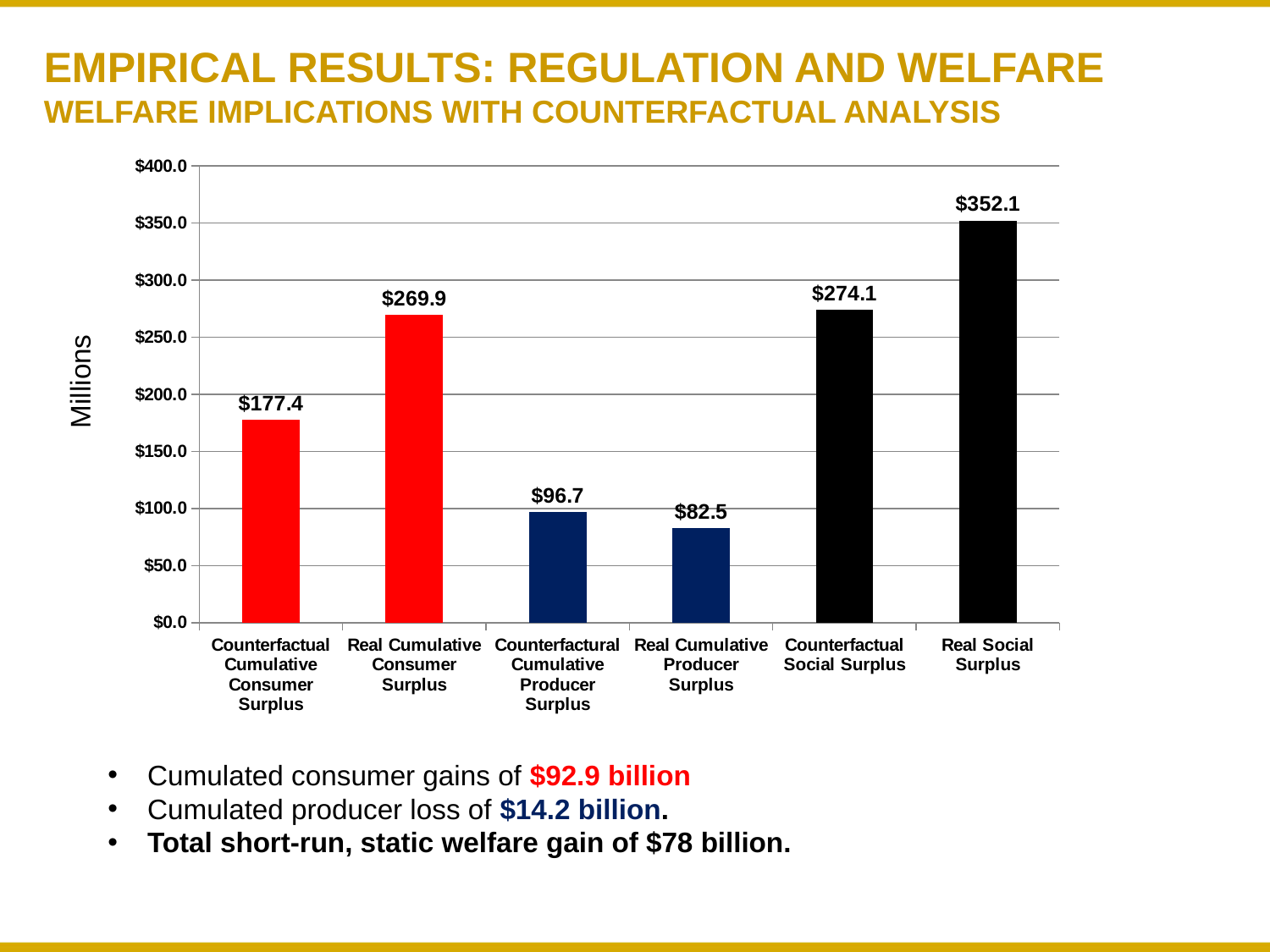
Which category has the highest value? Real Social Surplus What kind of chart is shown on the slide? bar chart Is the value for Counterfactual Social Surplus greater or less than $250.0? greater Which is larger, Counterfactural Cumulative Producer Surplus or Real Cumulative Producer Surplus? Counterfactural Cumulative Producer Surplus What is the value for Real Cumulative Producer Surplus? $82.5 What is the value for Real Social Surplus? $352.1 What is the difference between Real Social Surplus and Counterfactual Social Surplus? $78.0 Which category has the lowest value? Real Cumulative Producer Surplus How many bars are shown in the chart? 6 What is the label on the vertical axis? Millions What is the difference between Real Cumulative Consumer Surplus and Counterfactual Cumulative Consumer Surplus? $92.5 What is the value for Counterfactual Cumulative Consumer Surplus? $177.4